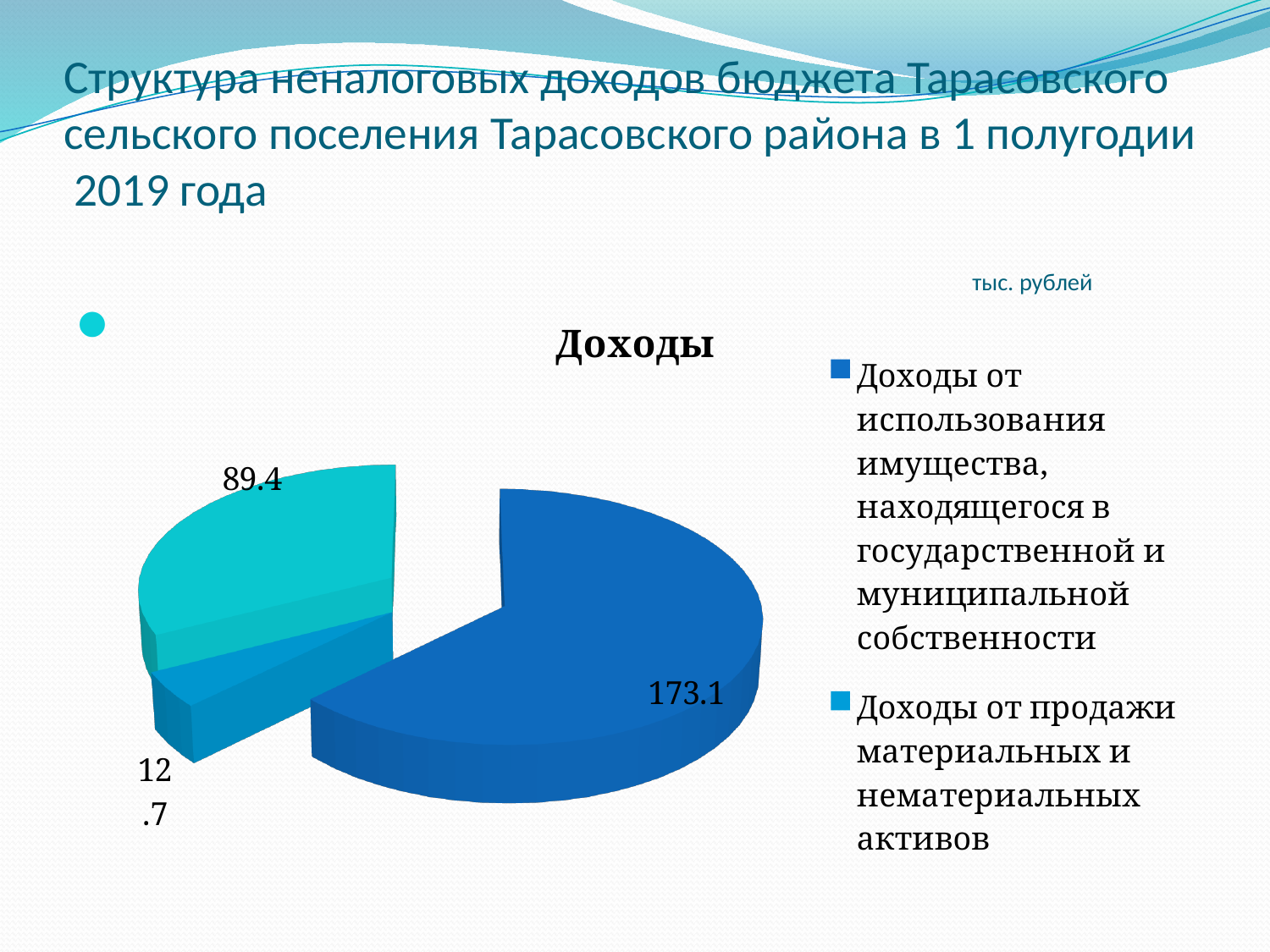
What is the title of the pie chart? Доходы What is the total of all slice values in the pie chart? 275.2 In what units are the values on the chart given, according to the slide? тыс. рублей What is the value of the slice for 'Доходы от использования имущества, находящегося в государственной и муниципальной собственности'? 173.1 What is the smallest value shown on the pie chart? 12.7 What kind of chart is shown on the slide? pie chart What is the largest value shown on the pie chart? 173.1 How many slices does the pie chart have? 3 What is the difference between the largest slice (173.1) and the slice labelled 89.4? 83.7 Which is larger: the slice labelled 89.4 or the slice labelled 12.7? 89.4 What is the difference between the slices labelled 89.4 and 12.7? 76.7 How many entries does the legend of the pie chart list? 2